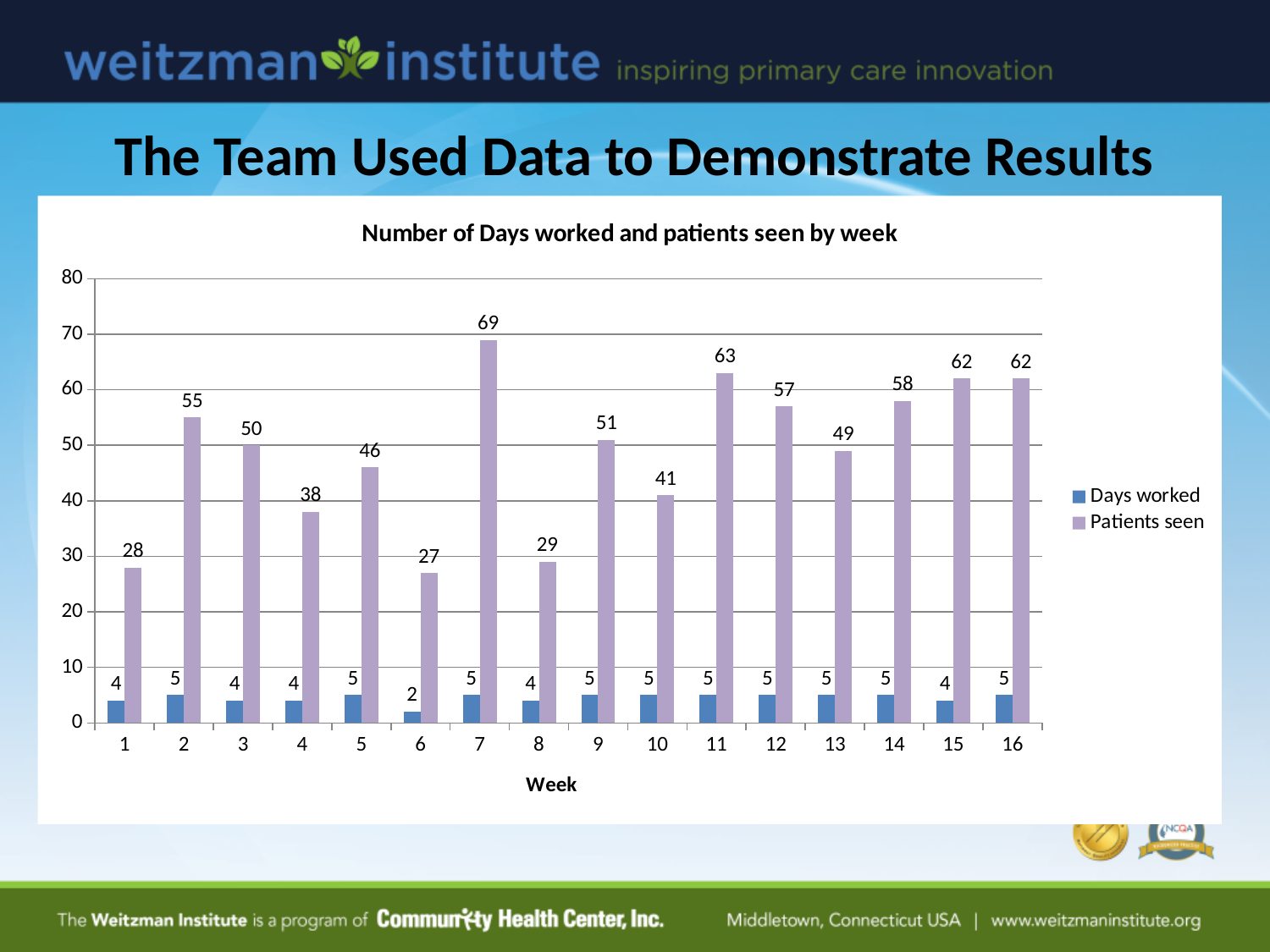
Which is larger, the number of patients seen in week 2 or in week 3? Week 2 Which week has the highest number of patients seen? Week 7 How many series does the legend list? 2 What is the difference in patients seen between week 7 and week 6? 42 Which week has the lowest number of patients seen? Week 6 What kind of chart is shown on the slide? Bar chart Is the number of patients seen in week 10 greater or less than 40? greater What is the title of the chart? Number of Days worked and patients seen by week How many days were worked in week 6? 2 What is the number of patients seen in week 15? 62 How many weeks are shown on the x axis? 16 What is the number of patients seen in week 7? 69